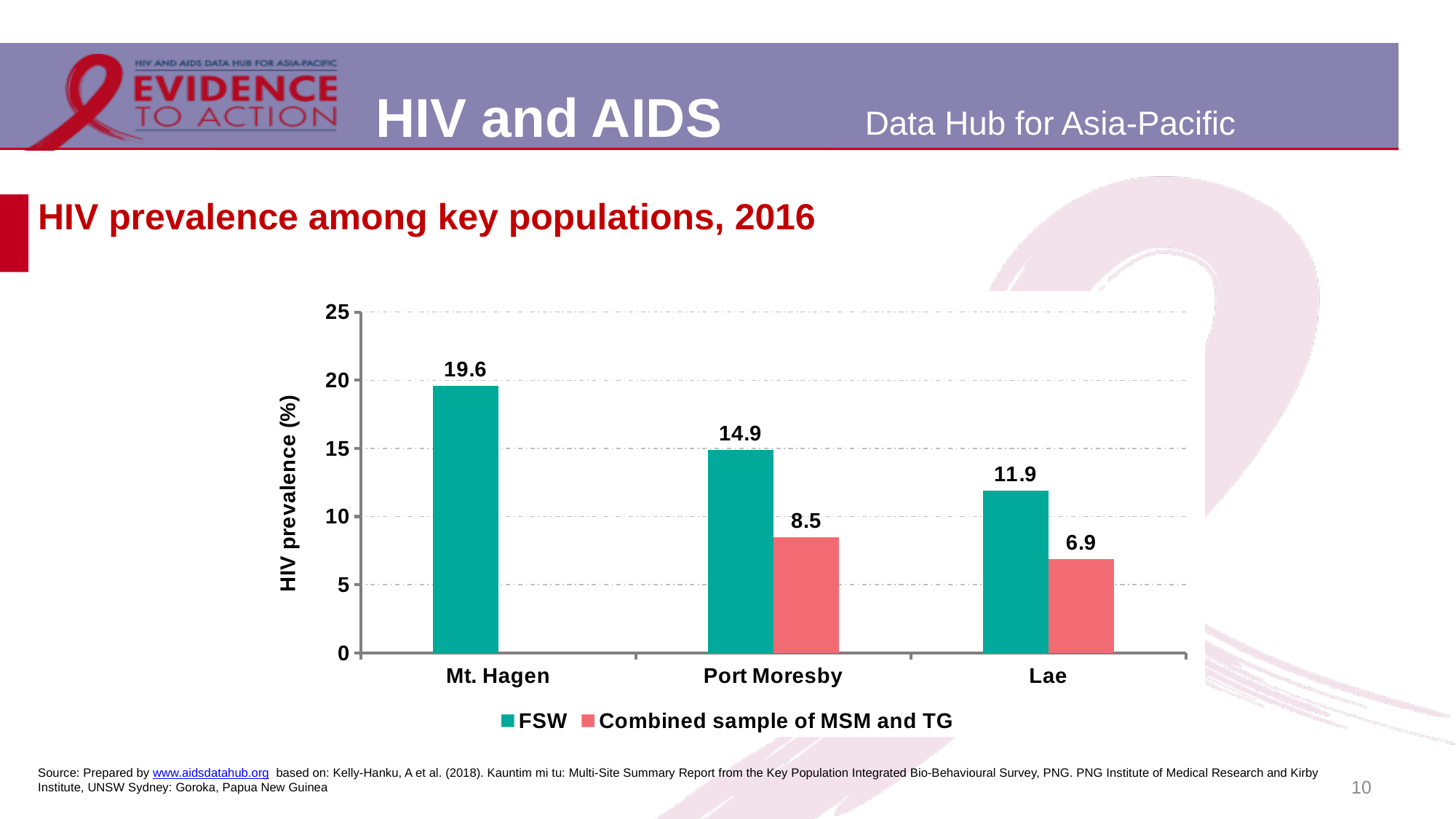
Is the FSW HIV prevalence in Mt. Hagen greater or less than 15? greater What is the HIV prevalence among FSW in Mt. Hagen? 19.6 How many series does the legend list? 2 What is the label of the y axis? HIV prevalence (%) What is the difference between the FSW and the combined MSM and TG HIV prevalence in Port Moresby? 6.4 What is the HIV prevalence among FSW in Lae? 11.9 Which city has the highest HIV prevalence among FSW? Mt. Hagen What kind of chart is shown on the slide? Bar chart Which is larger: the FSW HIV prevalence in Port Moresby or in Lae? Port Moresby What is the HIV prevalence for the combined sample of MSM and TG in Port Moresby? 8.5 Which city has the lowest HIV prevalence for the combined sample of MSM and TG? Lae How many cities are shown on the x axis? 3